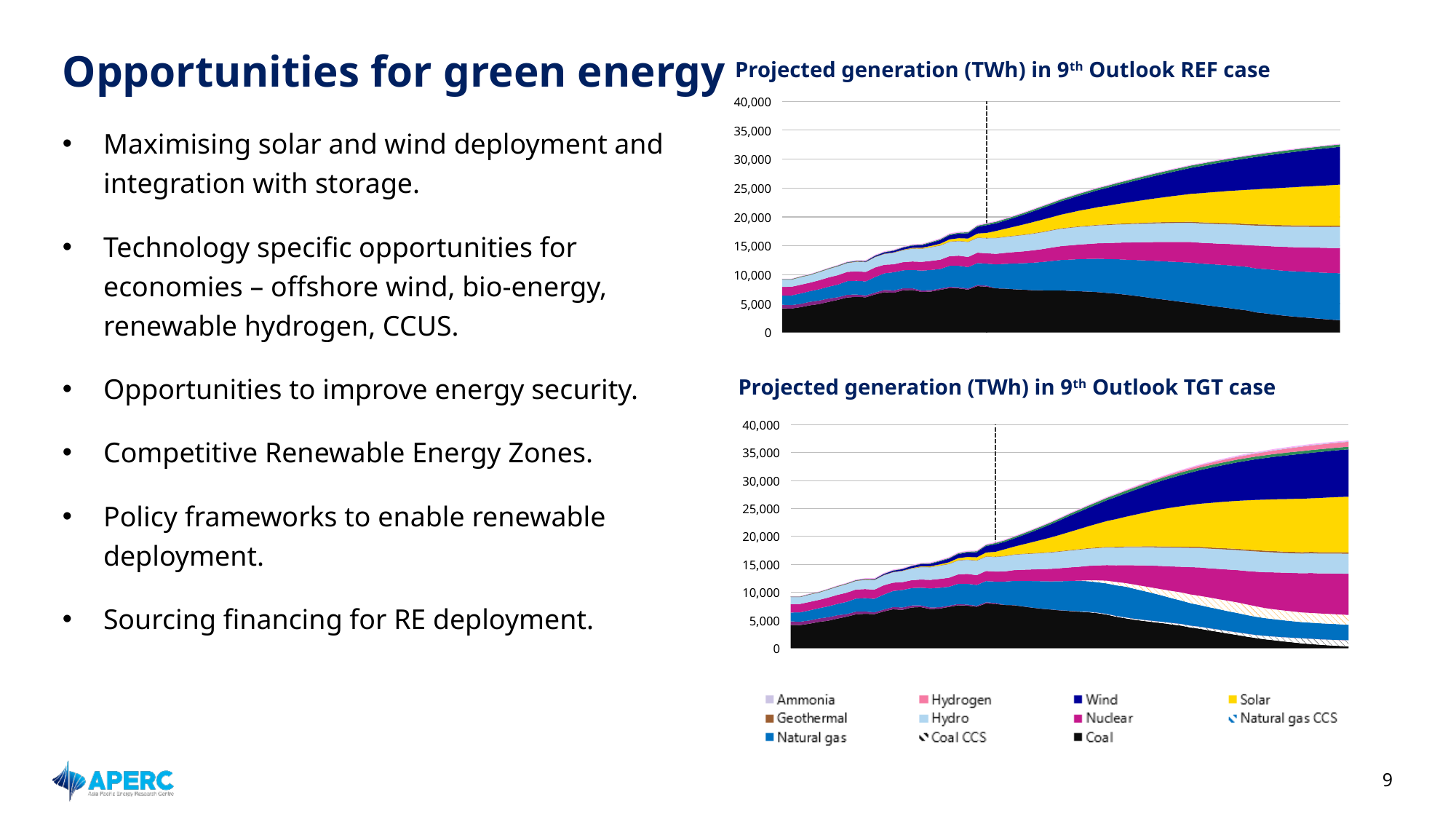
What is the title of the upper chart on the slide? Projected generation (TWh) in 9th Outlook REF case In the 'Projected generation (TWh) in 9th Outlook REF case' chart, is the total generation at the right end of the x axis greater or less than 35,000? less What colour represents Solar in the generation charts' legend? yellow In the 'Projected generation (TWh) in 9th Outlook REF case' chart, is the total generation at the right end of the x axis greater or less than 30,000? greater What kind of chart is the 'Projected generation (TWh) in 9th Outlook REF case' chart? stacked area chart In the 'Projected generation (TWh) in 9th Outlook TGT case' chart, is the total generation at the right end of the x axis greater or less than 35,000? greater How many series does the legend list for the generation charts? 11 Which chart reaches a higher total generation at the right end of the x axis, the REF case chart or the TGT case chart? TGT case In the 'Projected generation (TWh) in 9th Outlook TGT case' chart, does Coal generation rise or fall over the second half of the x axis? fall Does total projected generation rise or fall along the x axis in the 'Projected generation (TWh) in 9th Outlook REF case' chart? rise